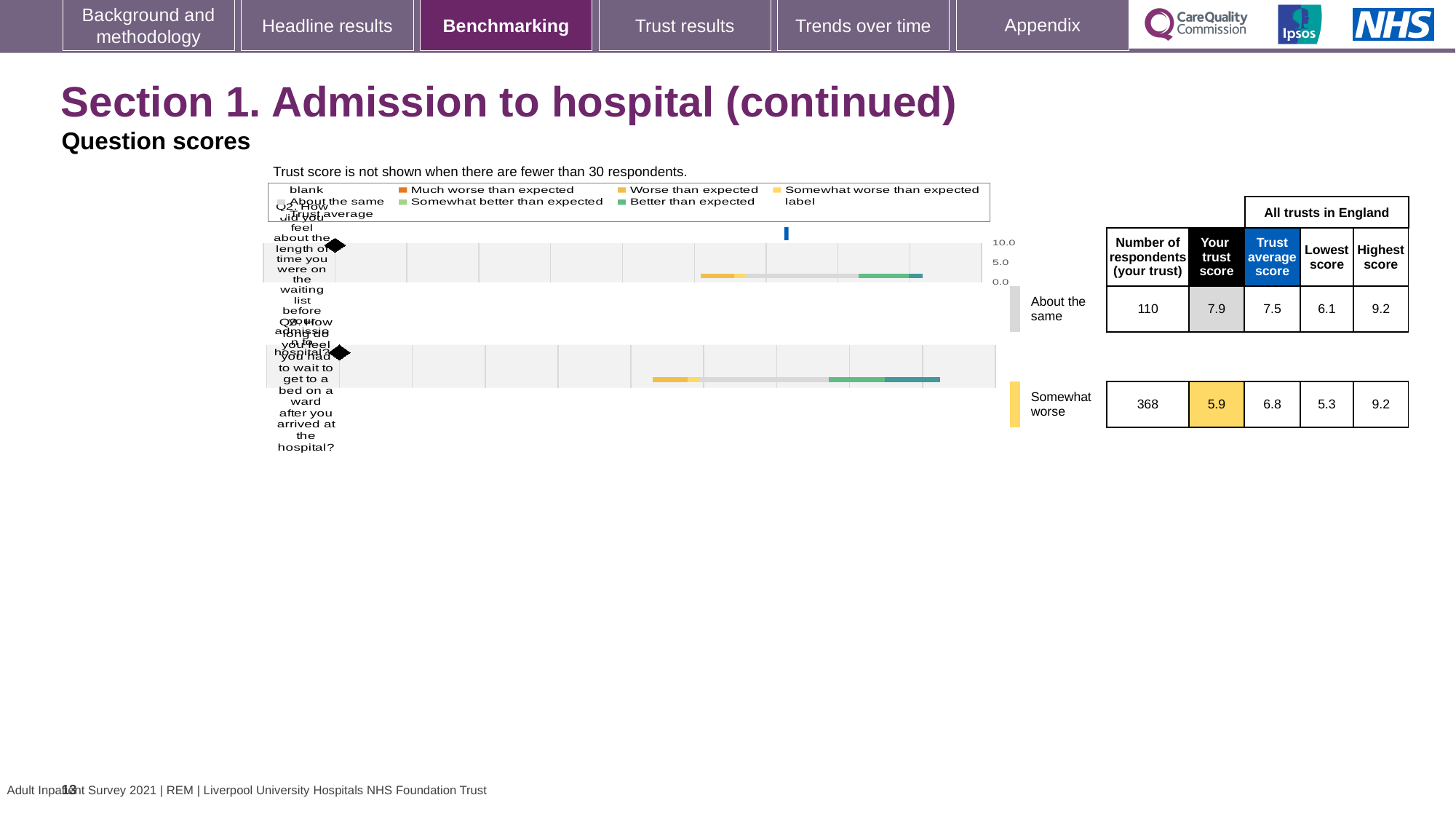
Which question has the higher trust score, Q2 or Q3? Q2 What is the trust score for Q3 (wait to get to a bed on a ward after arriving at the hospital)? 5.9 Is the trust score for Q3 greater or less than 5.0? greater What is the trust average score for Q2? 7.5 What is the trust score for Q2 (length of time on the waiting list before admission)? 7.9 What kind of chart is used to show the question scores on this slide? bar chart What is the highest score across all trusts in England for Q3? 9.2 By how much does the trust score for Q2 exceed the trust average score for Q2? 0.4 How many respondents answered Q3 at this trust? 368 What is the difference between the highest and lowest scores for Q3? 3.9 What benchmarking category is shown for Q3? Somewhat worse How many questions are plotted in the chart? 2